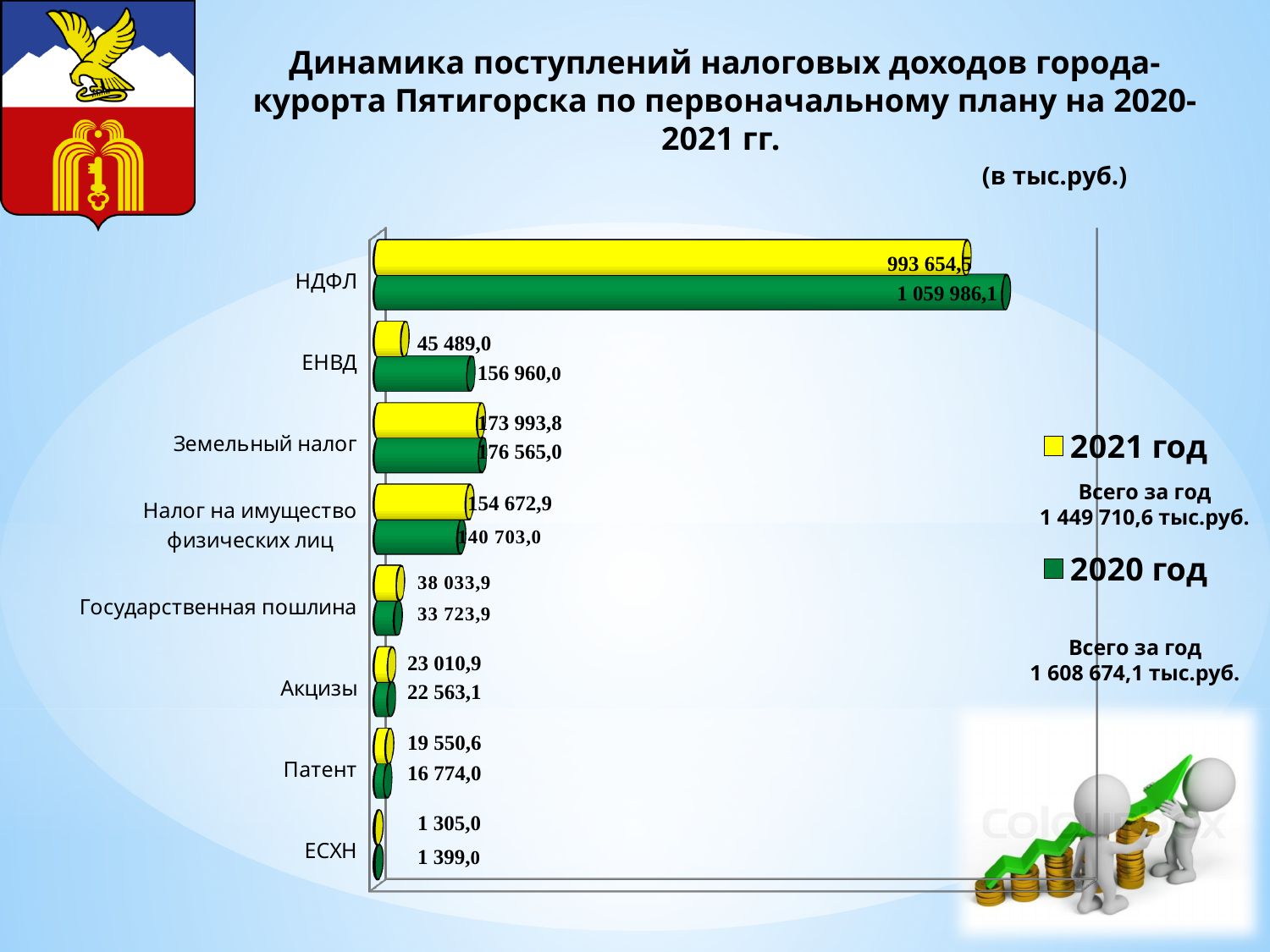
What is the difference between the 2020 год and 2021 год values for ЕНВД? 111 471,0 How many tax categories are plotted on the chart? 8 Which category has the highest value in the 2020 год series? НДФЛ Which category has the lowest value in the 2021 год series? ЕСХН How many series does the legend list? 2 What is the value for ЕНВД in the 2020 год series? 156 960,0 What is the difference between the 2021 год and 2020 год values for Патент? 2 776,6 What is the value for Акцизы in the 2021 год series? 23 010,9 What is the value for НДФЛ in the 2020 год series? 1 059 986,1 For Государственная пошлина, which series has the larger value, 2021 год or 2020 год? 2021 год Which colour represents the 2021 год series in the legend? yellow What kind of chart is shown on the slide? bar chart